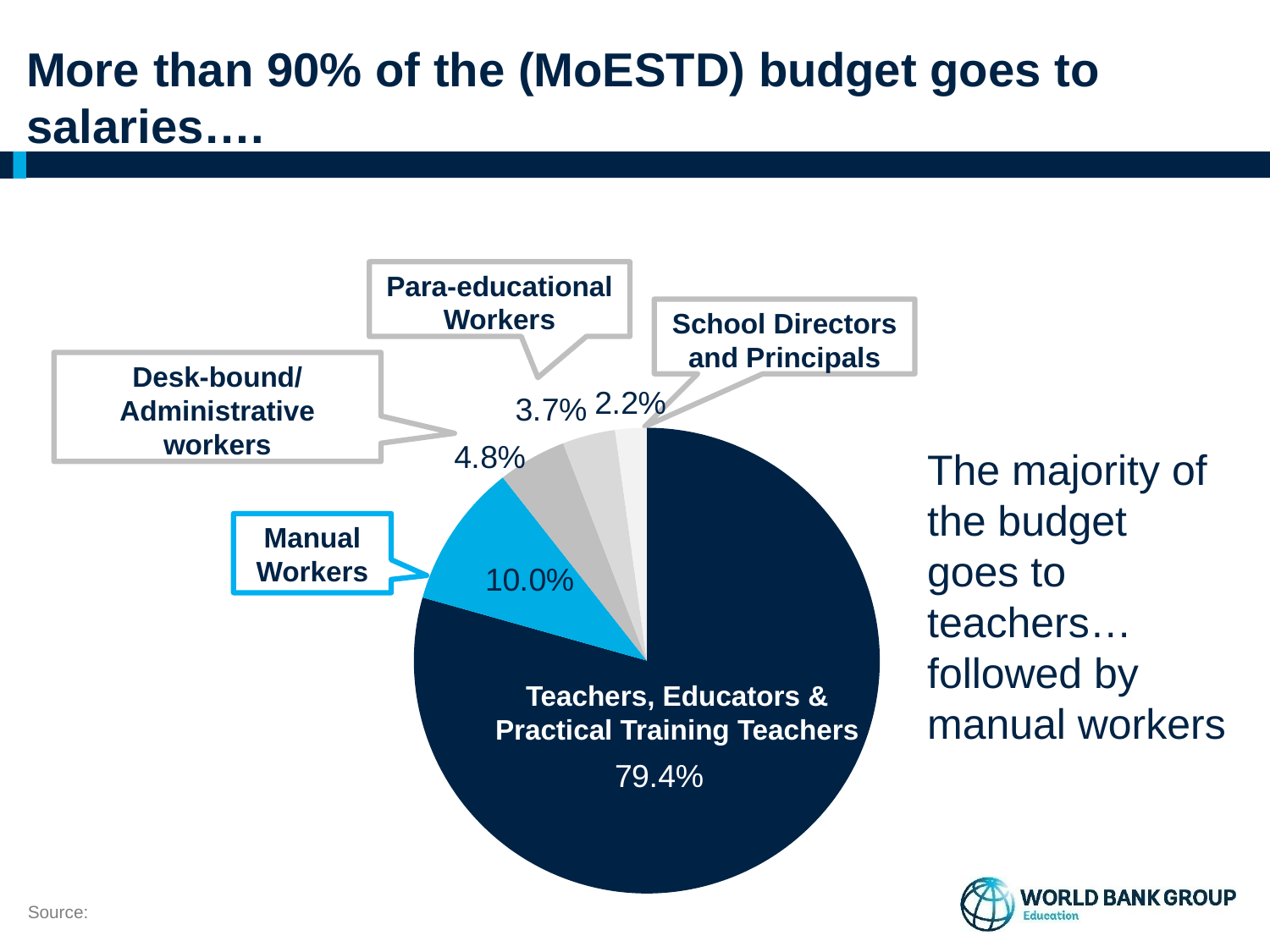
Which slice of the pie is coloured light blue? Manual Workers What share of the budget goes to Desk-bound/Administrative workers? 4.8% What kind of chart is shown on the slide? pie chart Which category has the smallest slice of the pie? School Directors and Principals What share of the budget goes to School Directors and Principals? 2.2% What is the difference between the Manual Workers share and the Desk-bound/Administrative workers share? 5.2% How many slices does the pie chart have? 5 What share of the budget goes to Teachers, Educators & Practical Training Teachers? 79.4% Which is larger, the share for Para-educational Workers or the share for School Directors and Principals? Para-educational Workers What share of the budget goes to Manual Workers? 10.0% What share of the budget goes to Para-educational Workers? 3.7% Which category has the largest slice of the pie? Teachers, Educators & Practical Training Teachers